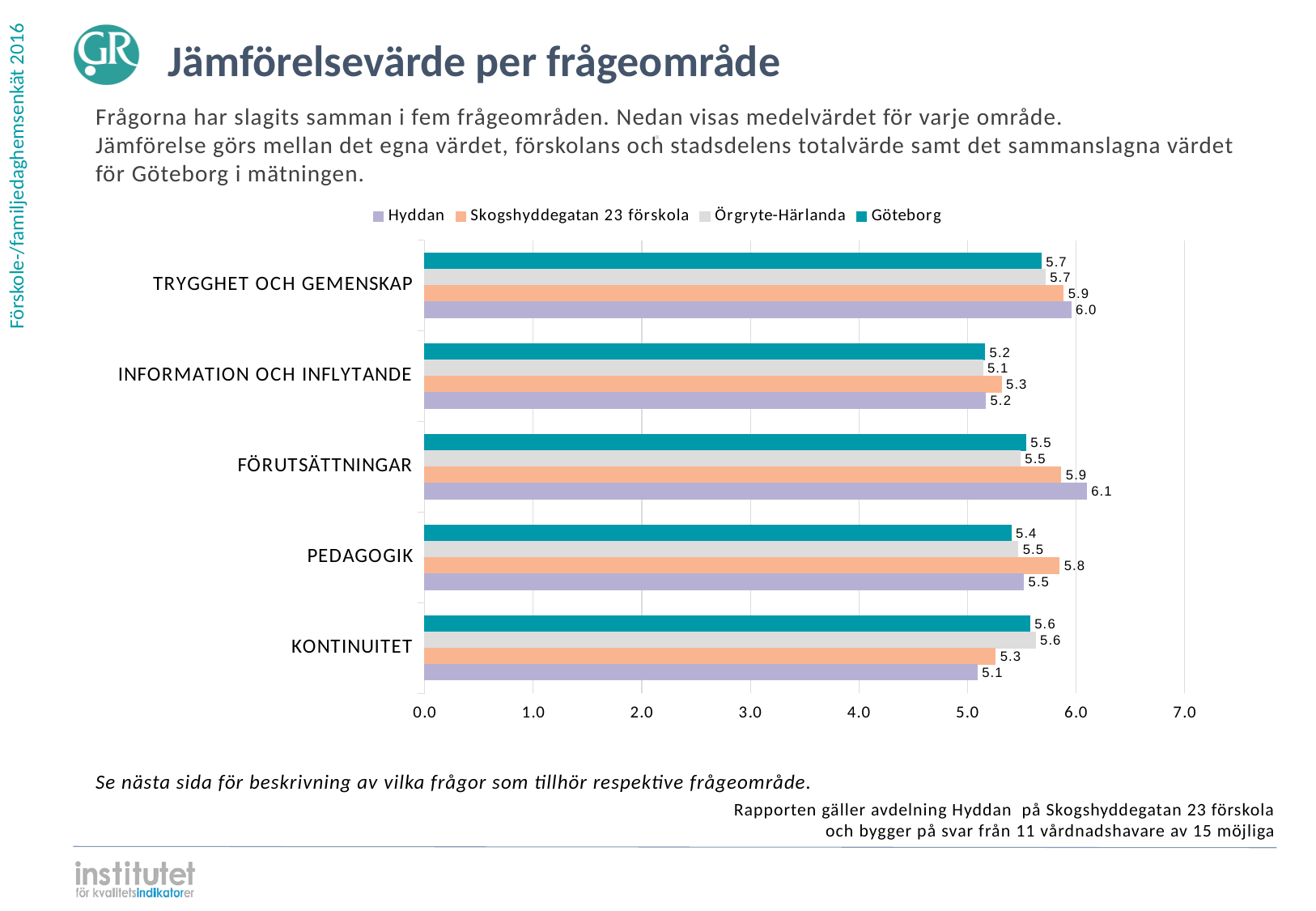
What is the value for Hyddan in the FÖRUTSÄTTNINGAR category? 6.1 In the KONTINUITET category, which is larger: the value for Göteborg or the value for Hyddan? Göteborg What is the difference between the Hyddan value and the Göteborg value in the TRYGGHET OCH GEMENSKAP category? 0.3 What kind of chart is shown on the slide? Bar chart What is the value for Örgryte-Härlanda in the INFORMATION OCH INFLYTANDE category? 5.1 In which category does Hyddan have its highest value? FÖRUTSÄTTNINGAR What is the value for Göteborg in the KONTINUITET category? 5.6 What is the title of the slide? Jämförelsevärde per frågeområde What is the value for Skogshyddegatan 23 förskola in the PEDAGOGIK category? 5.8 In which category does Hyddan have its lowest value? KONTINUITET How many categories are shown on the chart? 5 How many series does the legend list? 4